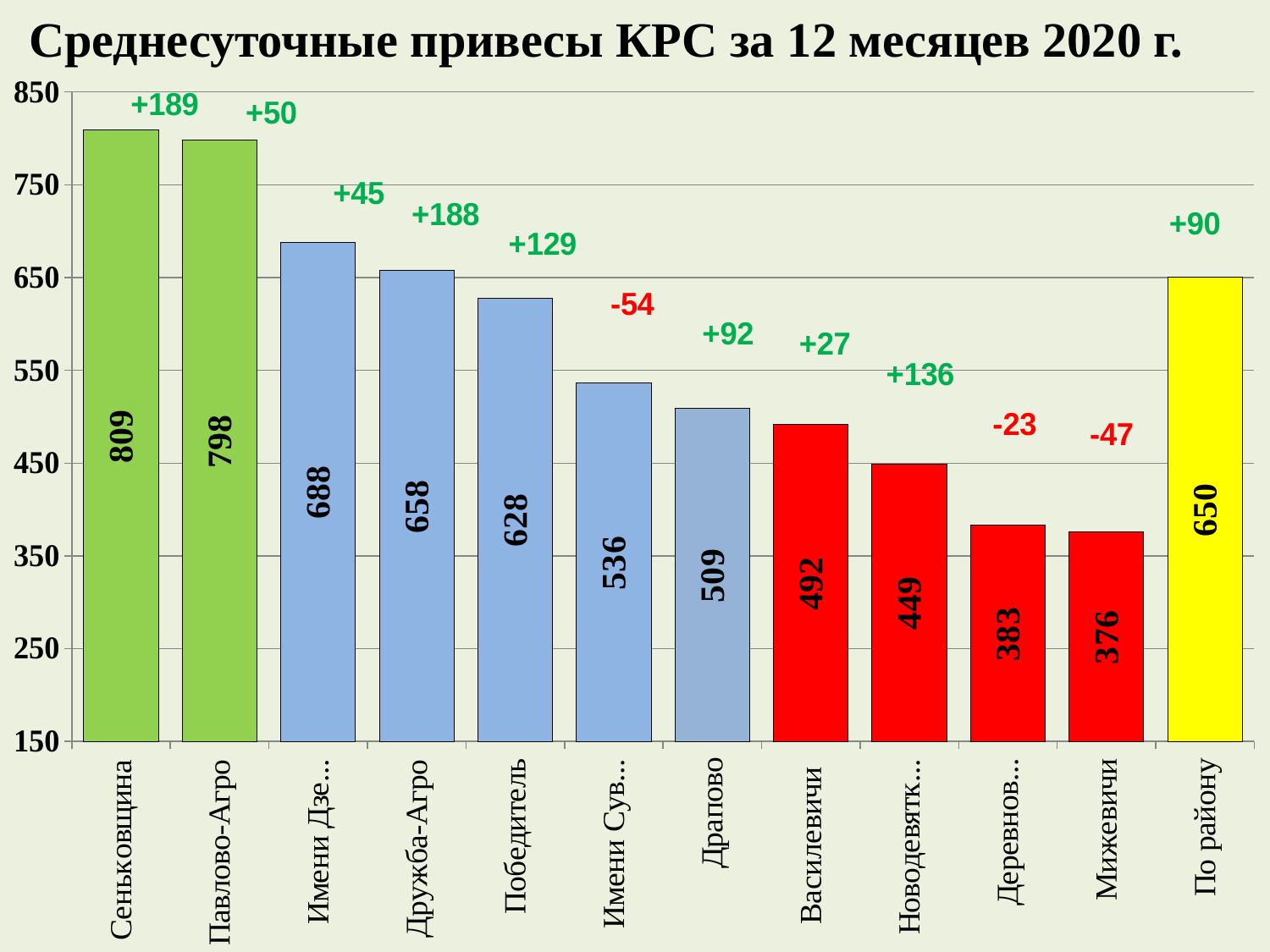
What is the value for Драпово? 509 Which category has the highest value? Сеньковщина What kind of chart is shown on the slide? Bar chart What is the change label shown above the bar for Дружба-Агро? +188 How many bars are shown in the chart? 12 Which is larger, the value for Василевичи or the value for Драпово? Драпово What is the value for По району? 650 What is the difference between the values for Дружба-Агро and Победитель? 30 What is the value for Мижевичи? 376 Which category has the lowest value? Мижевичи What is the value for Сеньковщина? 809 What is the difference between the values for Сеньковщина and Павлово-Агро? 11